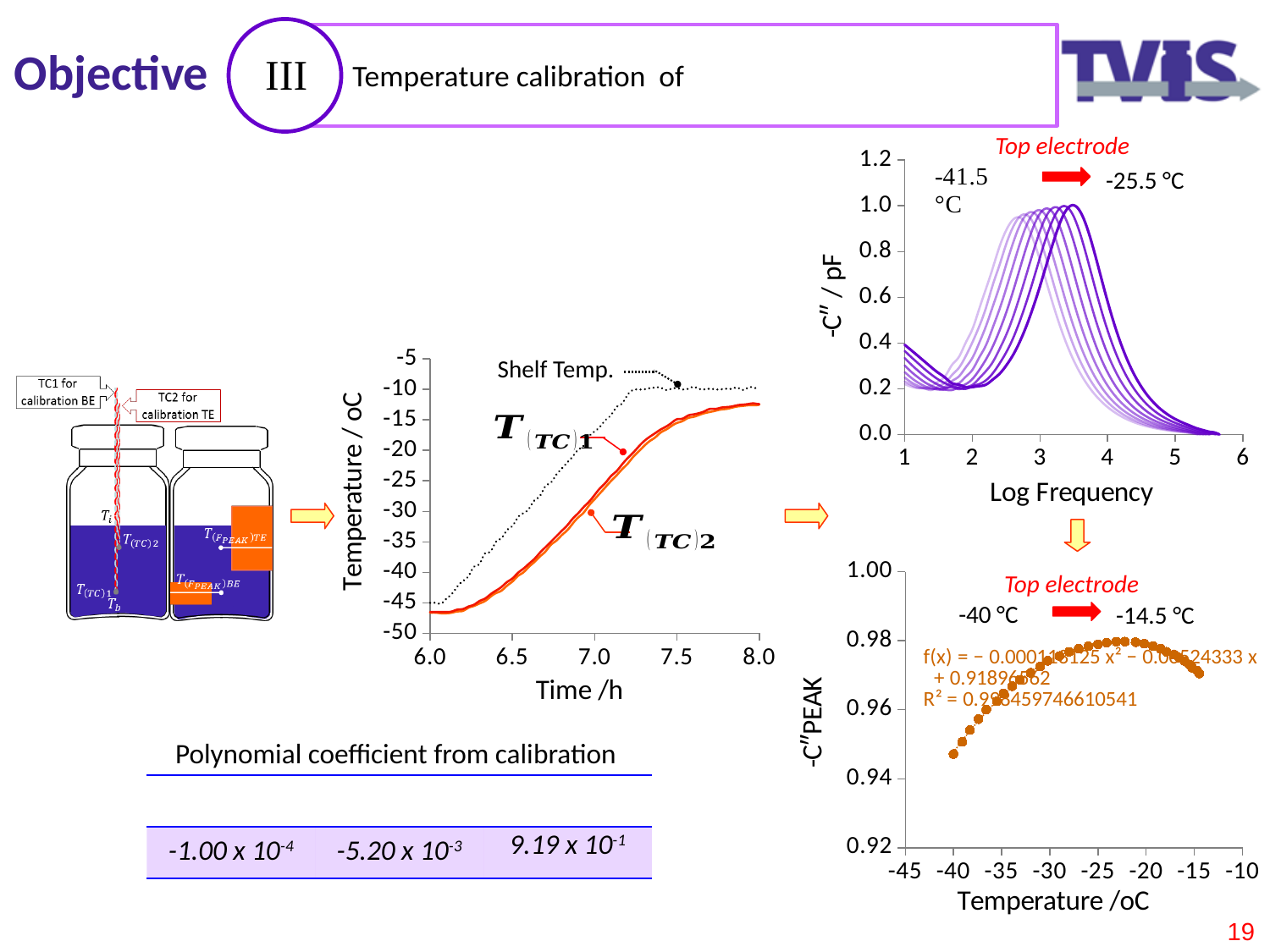
In the chart with x axis 'Log Frequency', is the peak value of the curves greater or less than 0.8? greater In the chart with x axis 'Temperature /oC', what temperature range is annotated for the top electrode? -40 °C to -14.5 °C In the chart with x axis 'Time /h', is the Shelf Temp. value at 8.0 h greater or less than -15? greater What kind of chart is the chart with x axis 'Temperature /oC'? scatter chart In the chart with x axis 'Log Frequency', what is the highest value shown on the y axis? 1.2 In the chart with x axis 'Temperature /oC', is the -C''PEAK value at -40 °C greater or less than 0.96? less In the chart with x axis 'Time /h', do the temperature curves rise or fall as time increases from 6.0 to 8.0 h? rise What kind of chart is the chart with x axis 'Log Frequency'? line chart In the chart with x axis 'Time /h', what is the label of the dotted series? Shelf Temp. In the chart with x axis 'Log Frequency', what temperature range is annotated for the top electrode? -41.5 °C to -25.5 °C What kind of chart is the chart with x axis 'Time /h'? line chart In the chart with x axis 'Time /h', what is the y-axis title? Temperature / oC